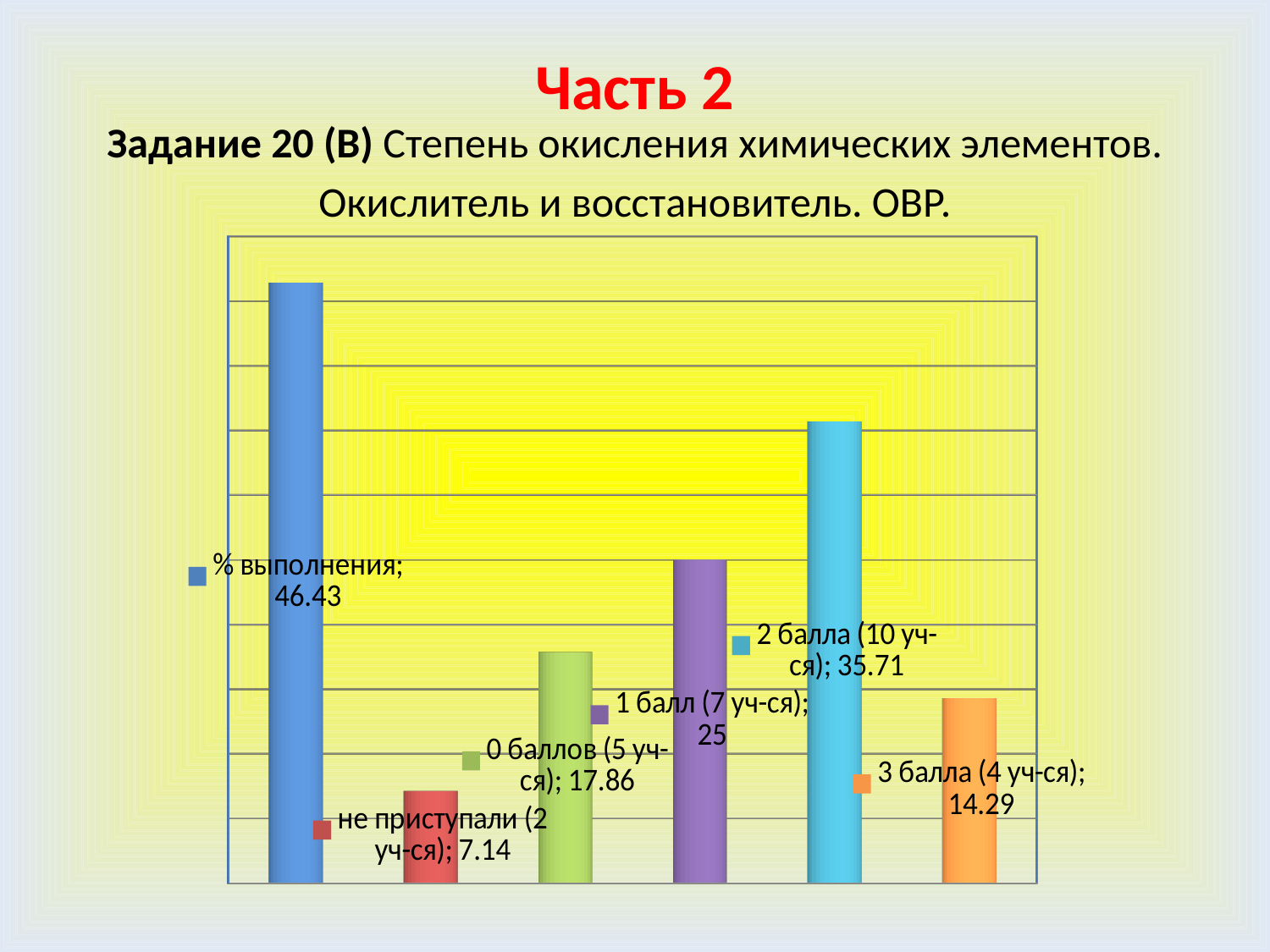
What is the difference between the values for "2 балла (10 уч-ся)" and "1 балл (7 уч-ся)"? 10.71 Which category has the highest value in the chart? % выполнения What is the value labelled for "% выполнения"? 46.43 What kind of chart is shown on the slide? bar chart What is the value labelled for "1 балл (7 уч-ся)"? 25 What is the value labelled for "не приступали (2 уч-ся)"? 7.14 How many bars are plotted in the chart? 6 What is the value labelled for "3 балла (4 уч-ся)"? 14.29 Which is larger: the value for "0 баллов (5 уч-ся)" or the value for "3 балла (4 уч-ся)"? 0 баллов (5 уч-ся) What is the value labelled for "2 балла (10 уч-ся)"? 35.71 What is the value labelled for "0 баллов (5 уч-ся)"? 17.86 Which category has the lowest value in the chart? не приступали (2 уч-ся)